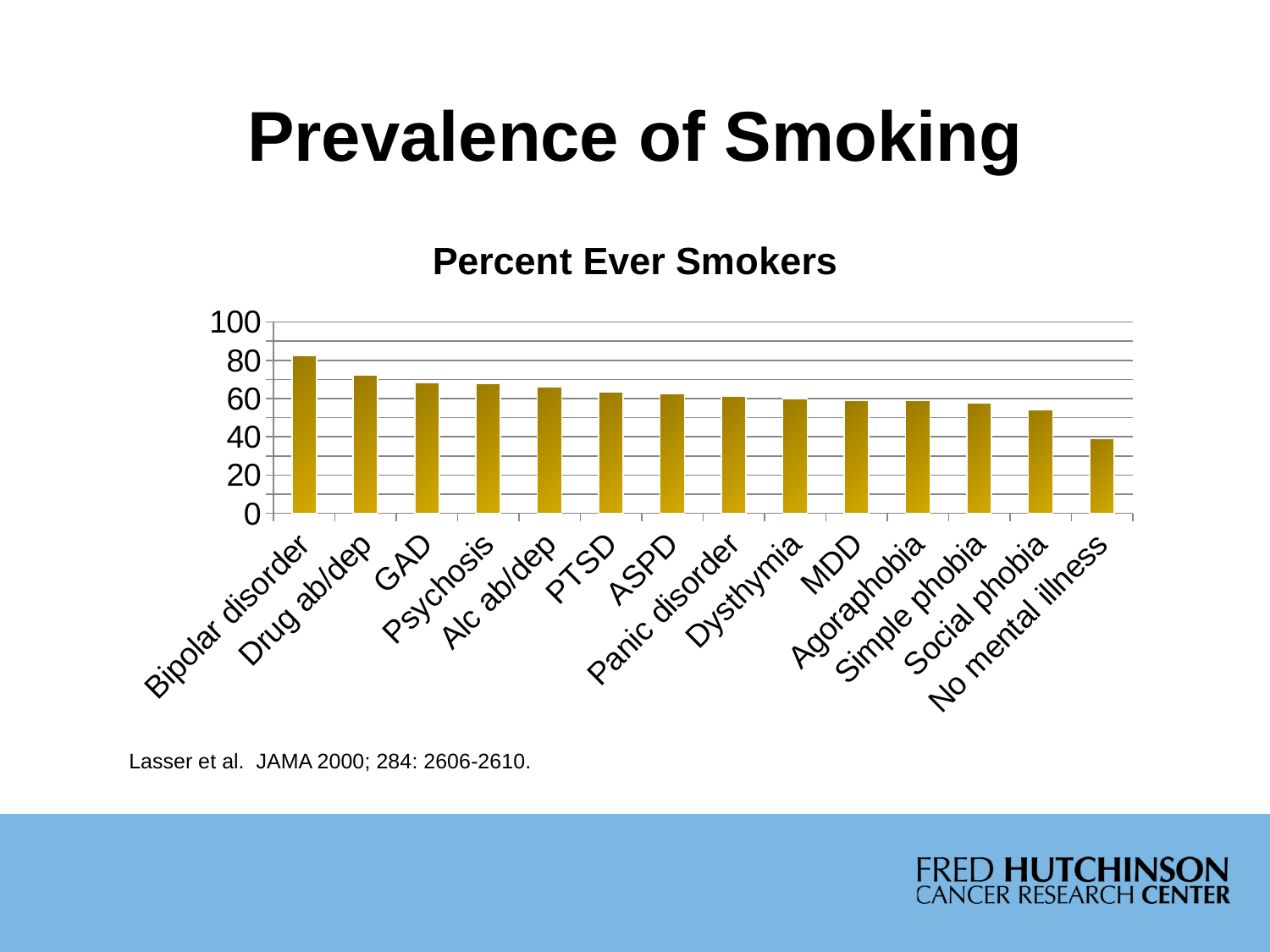
What is the title of the chart? Percent Ever Smokers How many categories are shown on the x axis of the chart? 14 Which is larger, the value for Bipolar disorder or the value for PTSD? Bipolar disorder Is the value for Drug ab/dep greater or less than 60? greater Which category has the lowest percent of ever smokers? No mental illness What kind of chart is shown on the slide? bar chart Which category has the highest percent of ever smokers? Bipolar disorder Which is larger, the value for Social phobia or the value for No mental illness? Social phobia Do the values rise or fall moving from left to right along the x axis? fall Is the value for Social phobia greater or less than 60? less